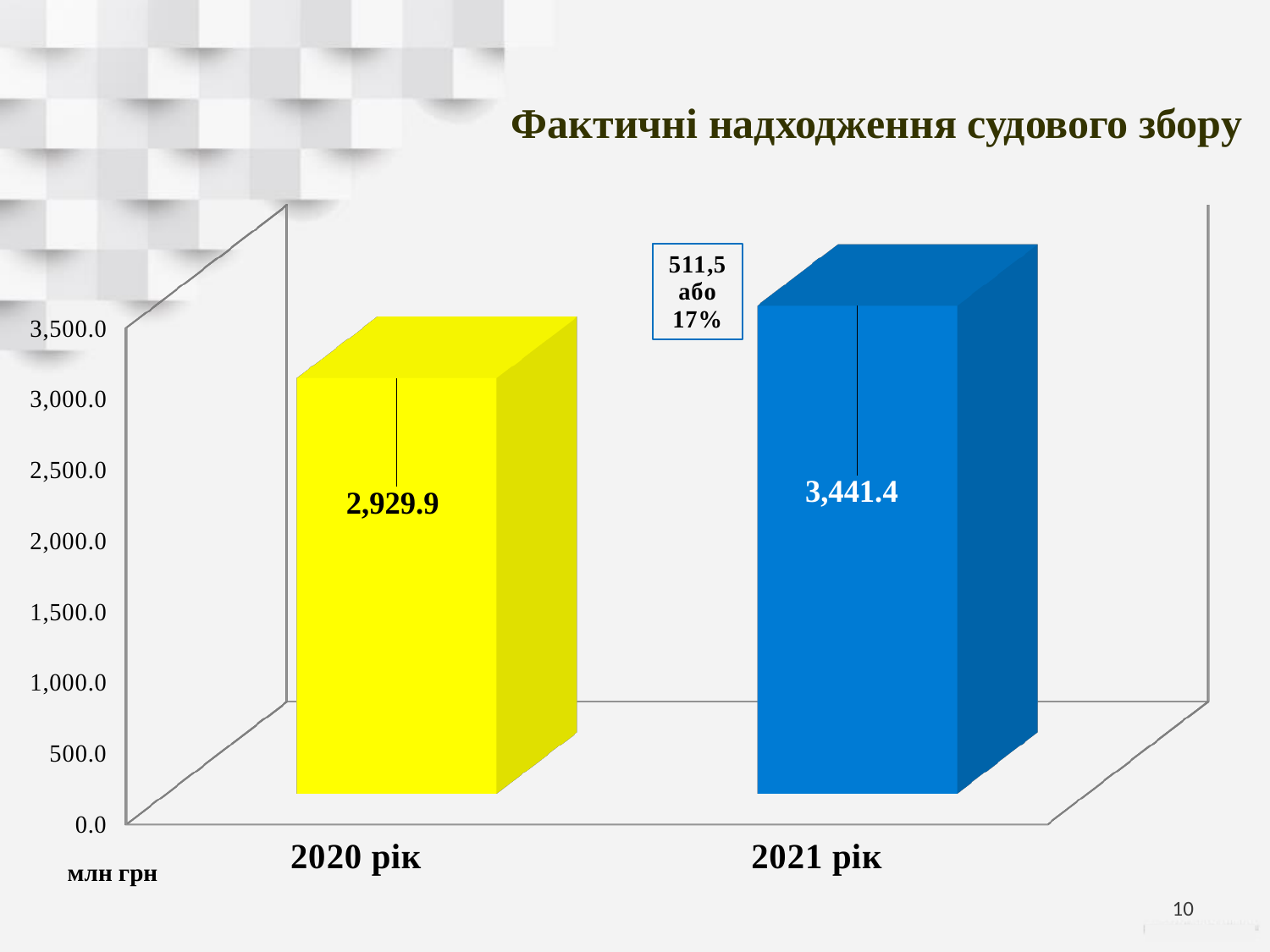
What is the value for 2021 рік? 3,441.4 What is the title of the chart? Фактичні надходження судового збору What is the value for 2020 рік? 2,929.9 Which is larger, the value for 2020 рік or the value for 2021 рік? 2021 рік What kind of chart is shown on the slide? bar chart Is the value for 2021 рік greater or less than 3,000.0? greater Which year has the lowest value? 2020 рік Which year has the highest value? 2021 рік Is the value for 2020 рік greater or less than 3,000.0? less What is the difference between the values for 2021 рік and 2020 рік? 511.5 How many categories are shown on the x axis? 2 Do the values rise or fall from 2020 рік to 2021 рік? rise